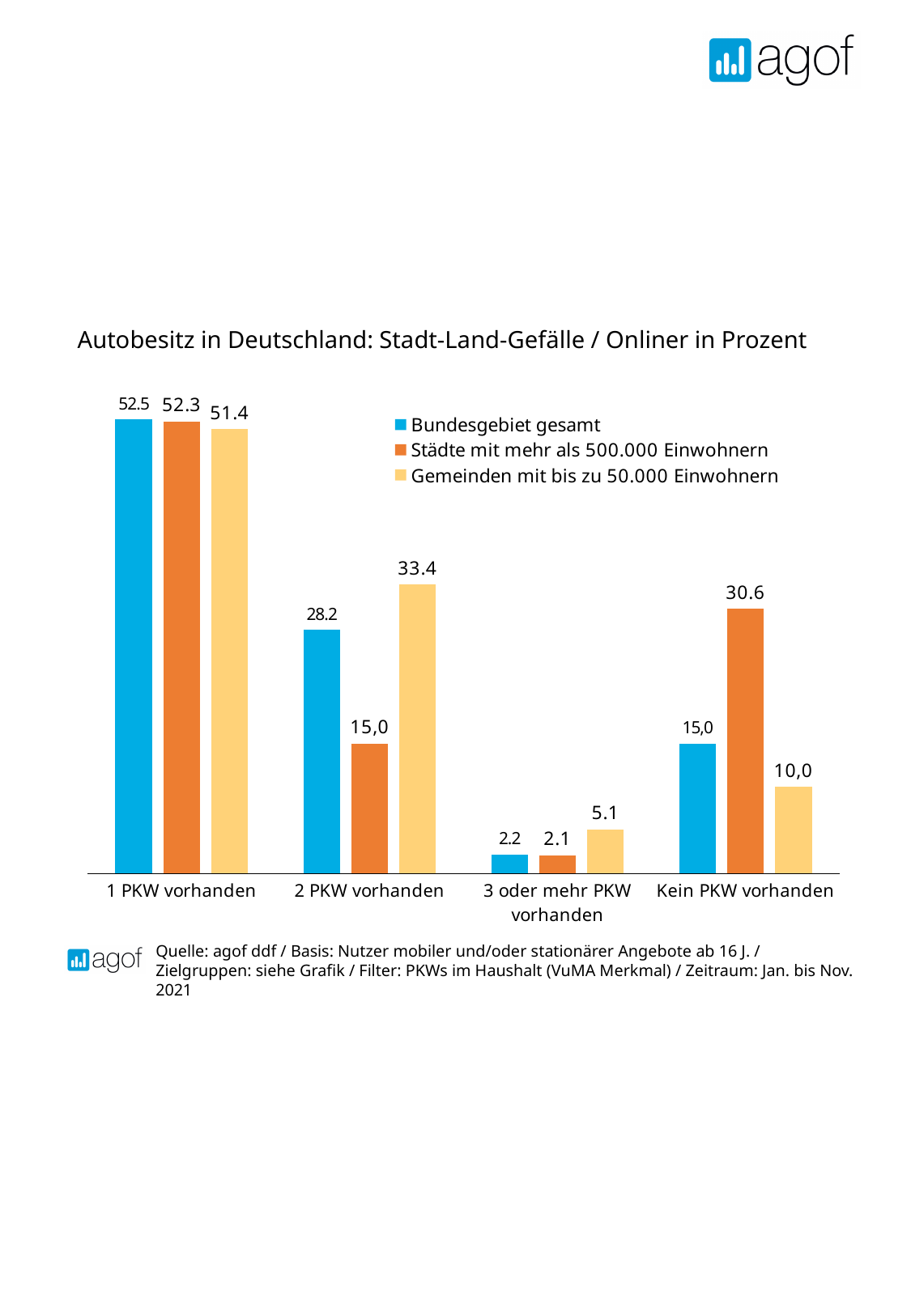
How many categories are shown on the x axis? 4 What is the value for Gemeinden mit bis zu 50.000 Einwohnern in the category 3 oder mehr PKW vorhanden? 5.1 In the category Kein PKW vorhanden, which series has the larger value: Bundesgebiet gesamt or Gemeinden mit bis zu 50.000 Einwohnern? Bundesgebiet gesamt Which category has the lowest value for Bundesgebiet gesamt? 3 oder mehr PKW vorhanden What is the value for Städte mit mehr als 500.000 Einwohnern in the category Kein PKW vorhanden? 30.6 What is the difference between the Gemeinden mit bis zu 50.000 Einwohnern value and the Städte mit mehr als 500.000 Einwohnern value in the category 2 PKW vorhanden? 18.4 What is the title of the chart? Autobesitz in Deutschland: Stadt-Land-Gefälle / Onliner in Prozent What kind of chart is shown on the slide? Bar chart How many series does the legend list? 3 What is the value for Bundesgebiet gesamt in the category 2 PKW vorhanden? 28.2 What is the value for Städte mit mehr als 500.000 Einwohnern in the category 2 PKW vorhanden? 15,0 Which category has the highest value for Gemeinden mit bis zu 50.000 Einwohnern? 1 PKW vorhanden